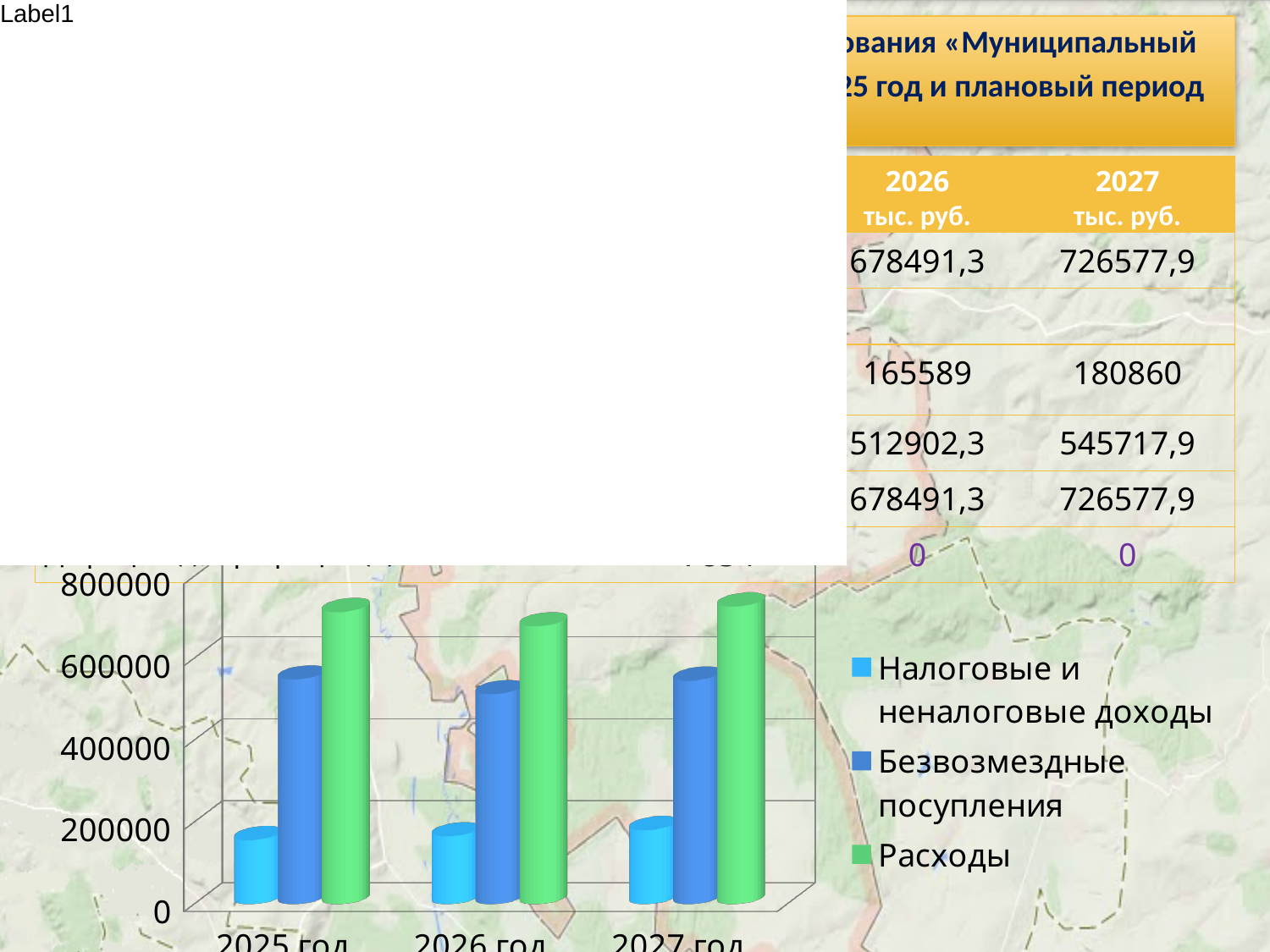
Do the bars for Налоговые и неналоговые доходы rise or fall from 2025 год to 2027 год? rise Which series has the tallest bar for 2025 год? Расходы Is the value for Налоговые и неналоговые доходы in 2025 год greater or less than 200000? less Is the value for Расходы in 2025 год greater or less than 600000? greater Which series has the shortest bar for 2027 год? Налоговые и неналоговые доходы What kind of chart is shown on the slide? bar chart How many year categories are shown on the x axis of the chart? 3 Is the value for Расходы in 2027 год greater or less than 800000? less For 2026 год, which is larger: Расходы or Безвозмездные посупления? Расходы What colour represents the Расходы series in the chart legend? green How many series does the chart legend list? 3